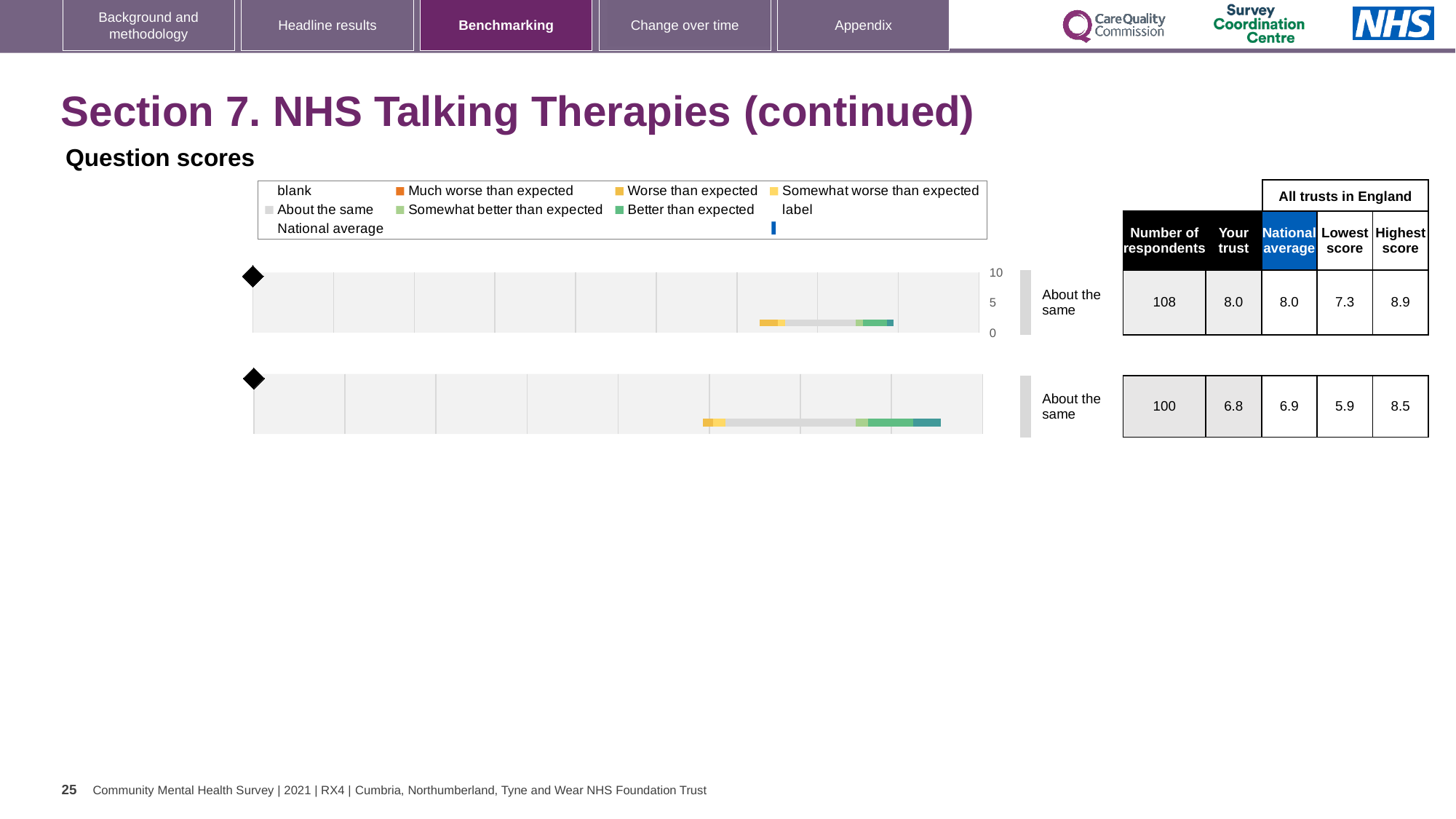
In the legend, what colour represents 'Much worse than expected'? orange What benchmark category label is shown next to both charts? About the same In the top chart, what is the difference between the Highest score and the Lowest score? 1.6 In the bottom chart, what is the Lowest score among all trusts in England? 5.9 In the top chart, what is the Highest score among all trusts in England? 8.9 In the bottom chart, what is the National average score? 6.9 In the bottom chart, which is larger: the Your trust score or the National average score? National average Is the Your trust score in the bottom chart greater or less than 5? greater In the top chart, what is the score for Your trust? 8.0 In the bottom chart, what is the difference between the National average and the Your trust score? 0.1 What kind of chart is used on the slide to show the question scores? bar chart How many respondents are shown for the bottom chart? 100